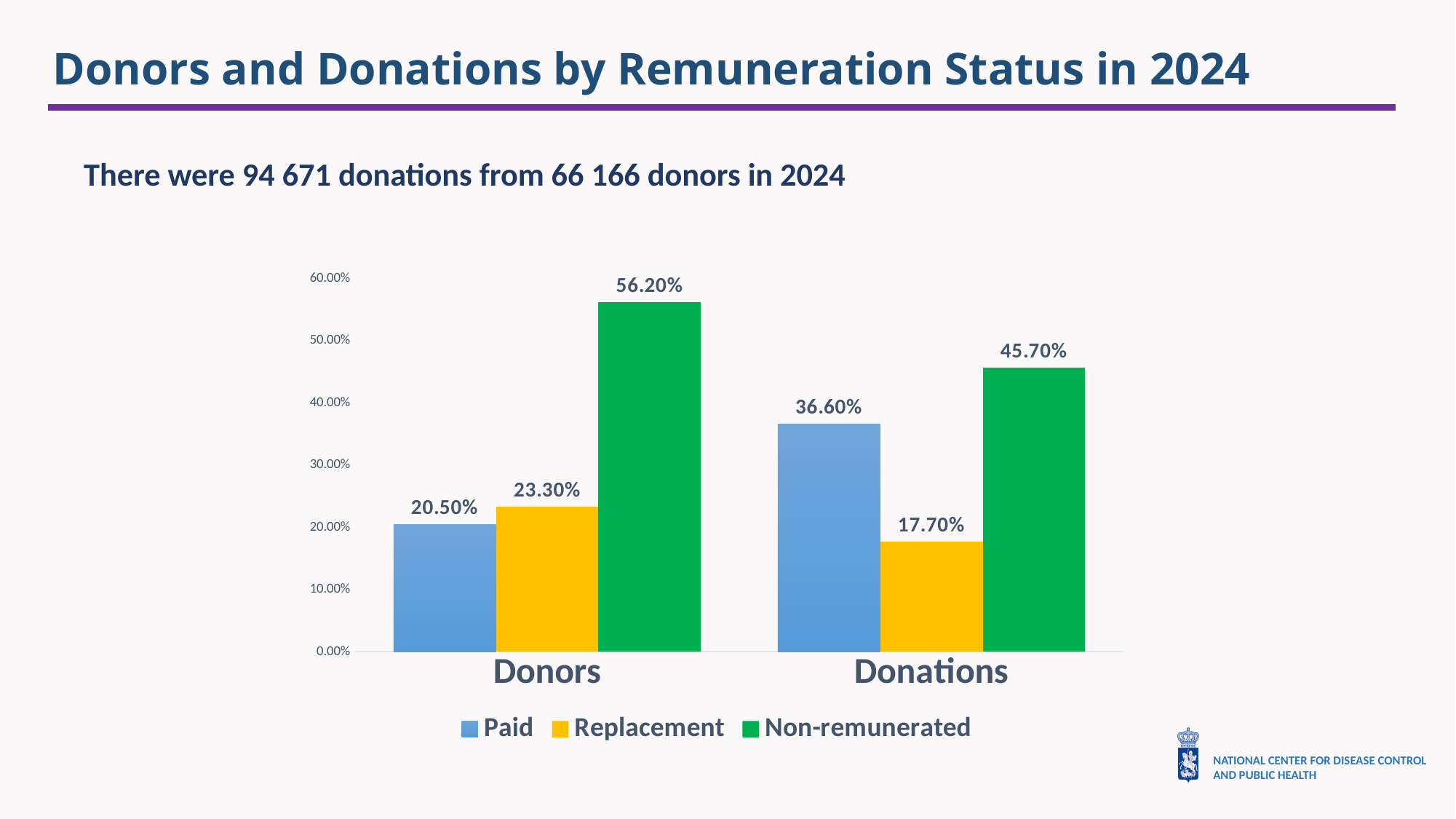
What is the value for Replacement in the Donations category? 17.70% How many categories are shown on the x axis? 2 Which is larger, the Paid value for Donors or the Paid value for Donations? Donations What kind of chart is shown on the slide? Bar chart What is the difference between the Paid and Replacement values in the Donors category? 2.80% What is the difference between the Non-remunerated values for Donors and Donations? 10.50% Which series has the lowest value in the Donations category? Replacement Which series has the highest value in the Donors category? Non-remunerated Is the Non-remunerated value for Donations greater or less than 40.00%? greater What is the value for Non-remunerated in the Donors category? 56.20% How many series does the legend list? 3 What is the value for Paid in the Donations category? 36.60%